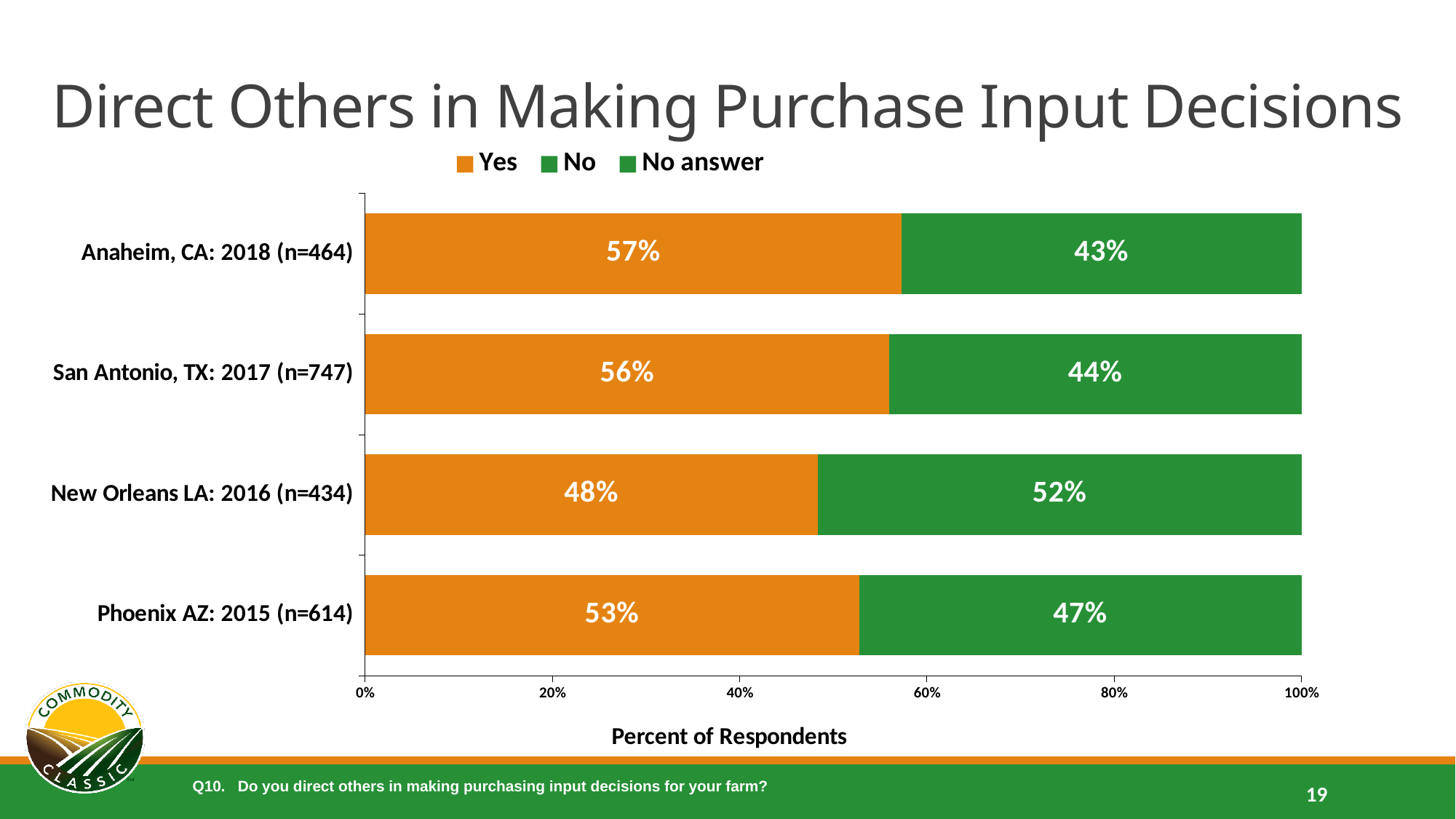
What is the difference between the Yes and No percentages for San Antonio, TX: 2017 (n=747)? 12% Which category has the lowest Yes percentage? New Orleans LA: 2016 (n=434) Which category has the highest Yes percentage? Anaheim, CA: 2018 (n=464) Is the Yes percentage larger for Phoenix AZ: 2015 (n=614) or for New Orleans LA: 2016 (n=434)? Phoenix AZ: 2015 (n=614) What percentage of respondents answered Yes for Anaheim, CA: 2018 (n=464)? 57% What is the total of the Yes and No segments for Anaheim, CA: 2018 (n=464)? 100% How many categories (survey years) are shown on the chart? 4 What is the Yes value for Phoenix AZ: 2015 (n=614)? 53% What percentage of respondents answered No for New Orleans LA: 2016 (n=434)? 52% How many series does the legend list? 3 What is the label of the x axis? Percent of Respondents What kind of chart is shown on the slide? Stacked bar chart